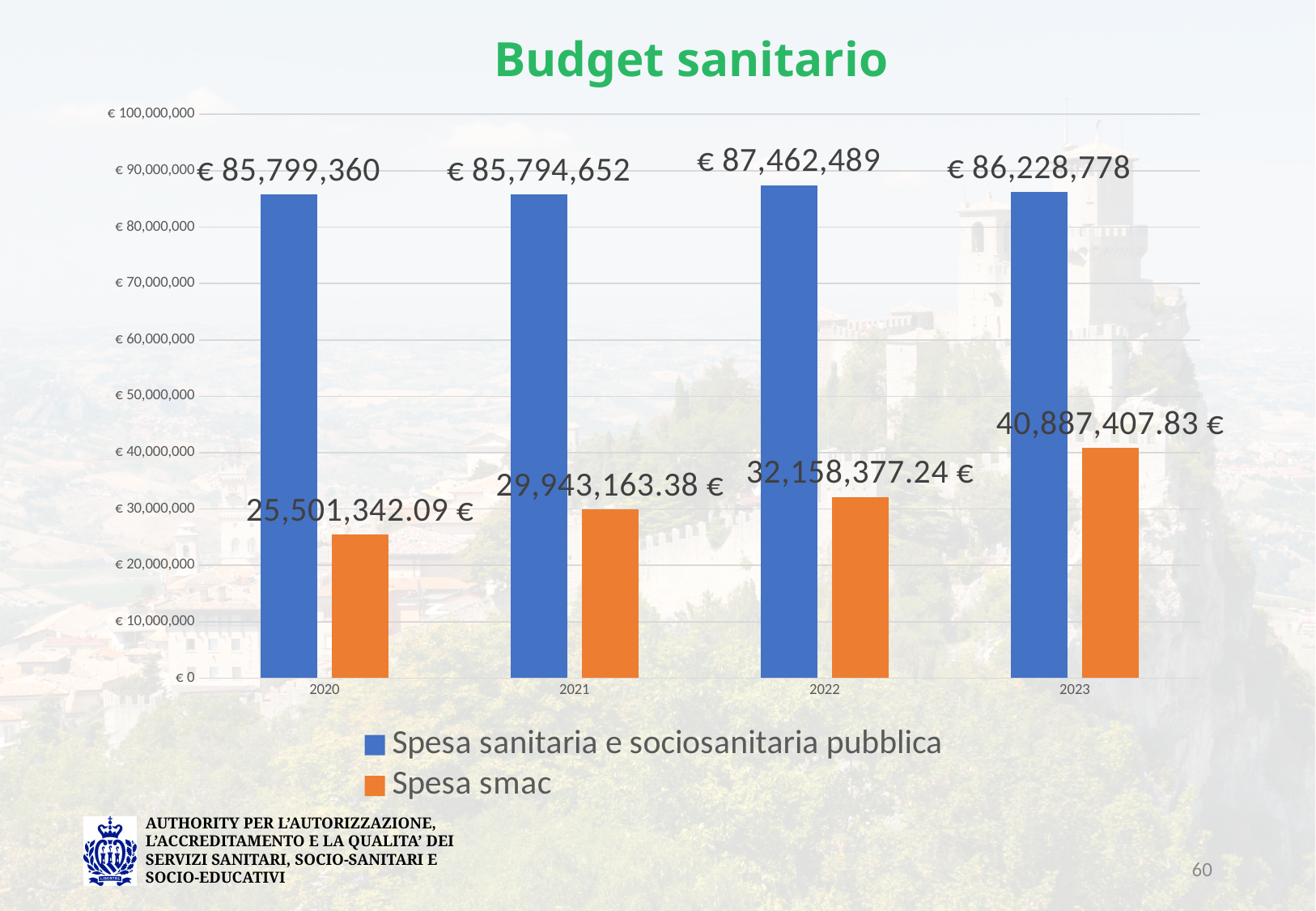
What is the value of Spesa sanitaria e sociosanitaria pubblica in 2021? € 85,794,652 What is the difference between Spesa smac in 2023 and in 2020? 15,386,065.74 € What is the value of Spesa smac in 2020? 25,501,342.09 € What type of chart is shown on the slide? Bar chart In which year is Spesa smac lowest? 2020 What is the value of Spesa sanitaria e sociosanitaria pubblica in 2022? € 87,462,489 What is the value of Spesa smac in 2023? 40,887,407.83 € In which year is Spesa sanitaria e sociosanitaria pubblica highest? 2022 How many years are shown on the x axis? 4 How many series does the legend list? 2 Which is larger: Spesa smac in 2022 or Spesa smac in 2021? Spesa smac in 2022 Does Spesa smac rise or fall from 2020 to 2023? Rise